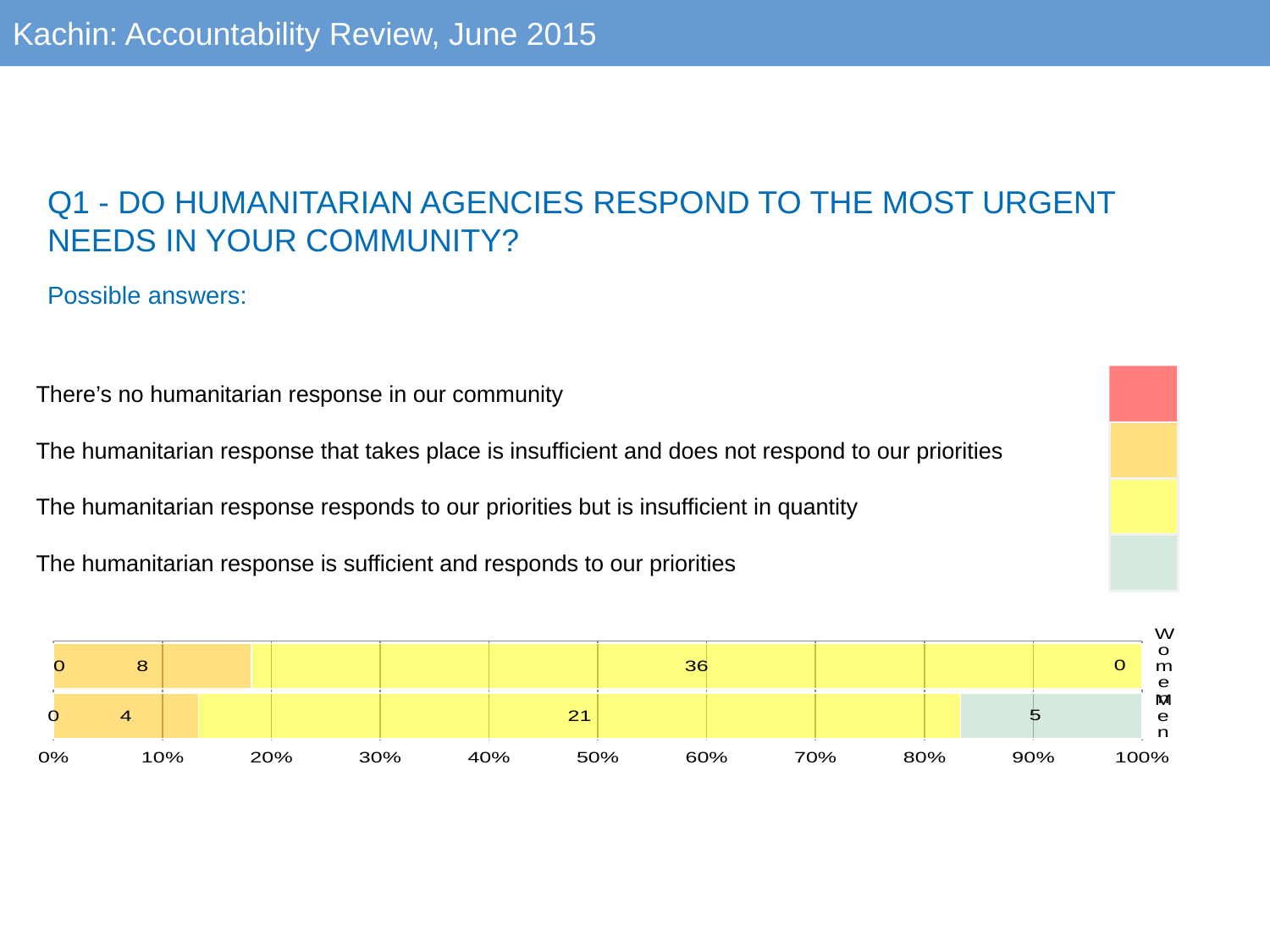
What is the value of the yellow segment (response responds to priorities but insufficient in quantity) for Women? 36 How many bars (groups) does the chart show? 2 What is the difference between the yellow segment values for Women and Men? 15 What is the total number of responses in the Men bar? 30 What type of chart is shown at the bottom of the slide? Stacked bar chart Which colour in the legend represents the answer 'The humanitarian response is sufficient and responds to our priorities'? Green What is the value of the yellow segment (response responds to priorities but insufficient in quantity) for Men? 21 Which group has the larger orange segment value, Women or Men? Women What is the total number of responses in the Women bar? 44 What is the value of the green segment (response sufficient and responds to priorities) for Men? 5 What is the value of the green segment (response sufficient and responds to priorities) for Women? 0 What is the value of the orange segment (response insufficient and does not respond to priorities) for Women? 8